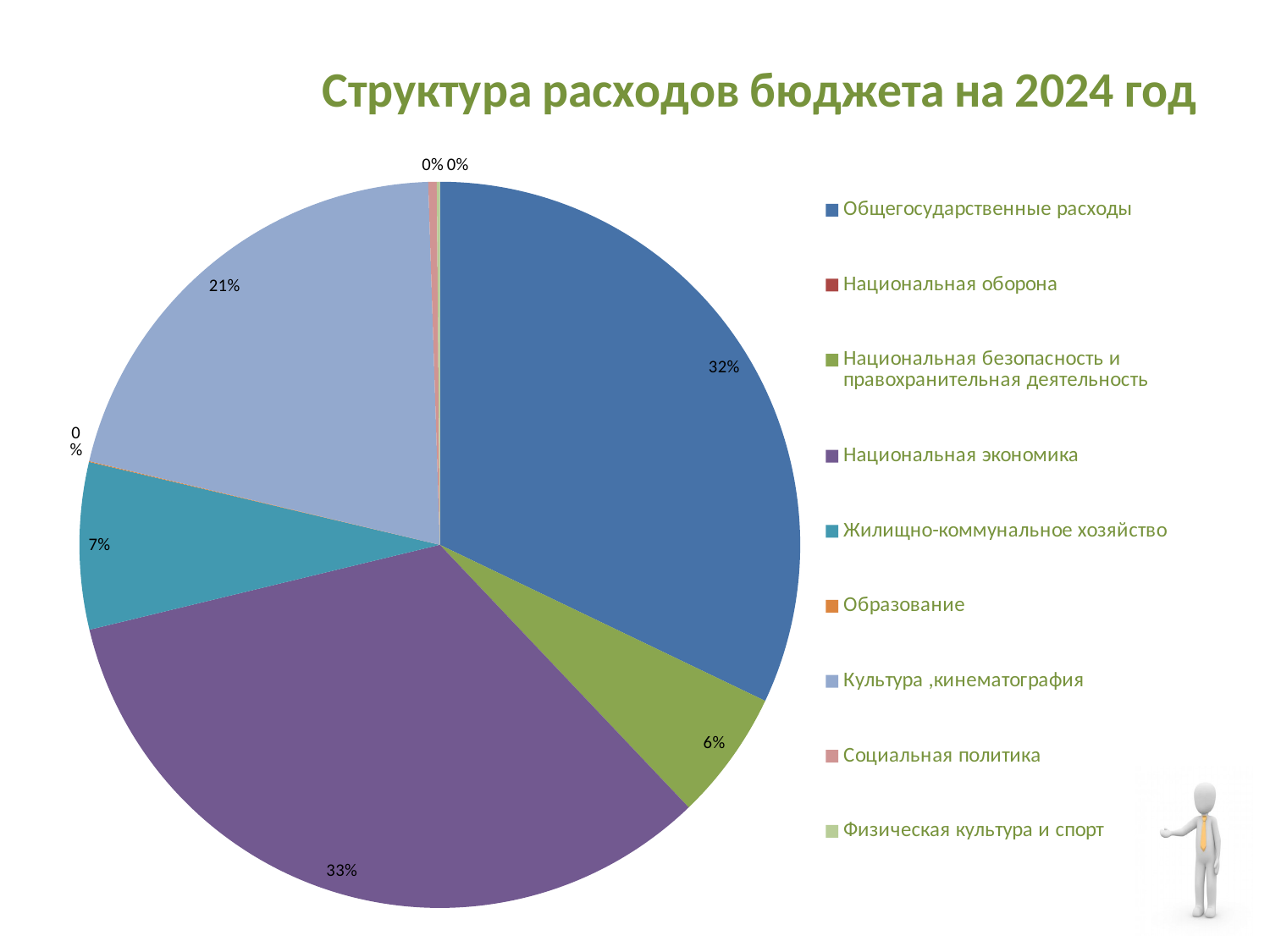
What kind of chart is shown on the slide? pie chart How many entries does the chart legend list? 9 What share of the pie is Общегосударственные расходы? 32% What is the difference in percentage points between the Национальная экономика slice and the Культура ,кинематография slice? 12 What is the title of the chart? Структура расходов бюджета на 2024 год Which is larger: the slice for Жилищно-коммунальное хозяйство or the slice for Национальная безопасность и правохранительная деятельность? Жилищно-коммунальное хозяйство What colour is the slice for Национальная экономика? purple What share of the pie is Жилищно-коммунальное хозяйство? 7% What share of the pie is Национальная безопасность и правохранительная деятельность? 6% Which category has the largest slice of the pie? Национальная экономика